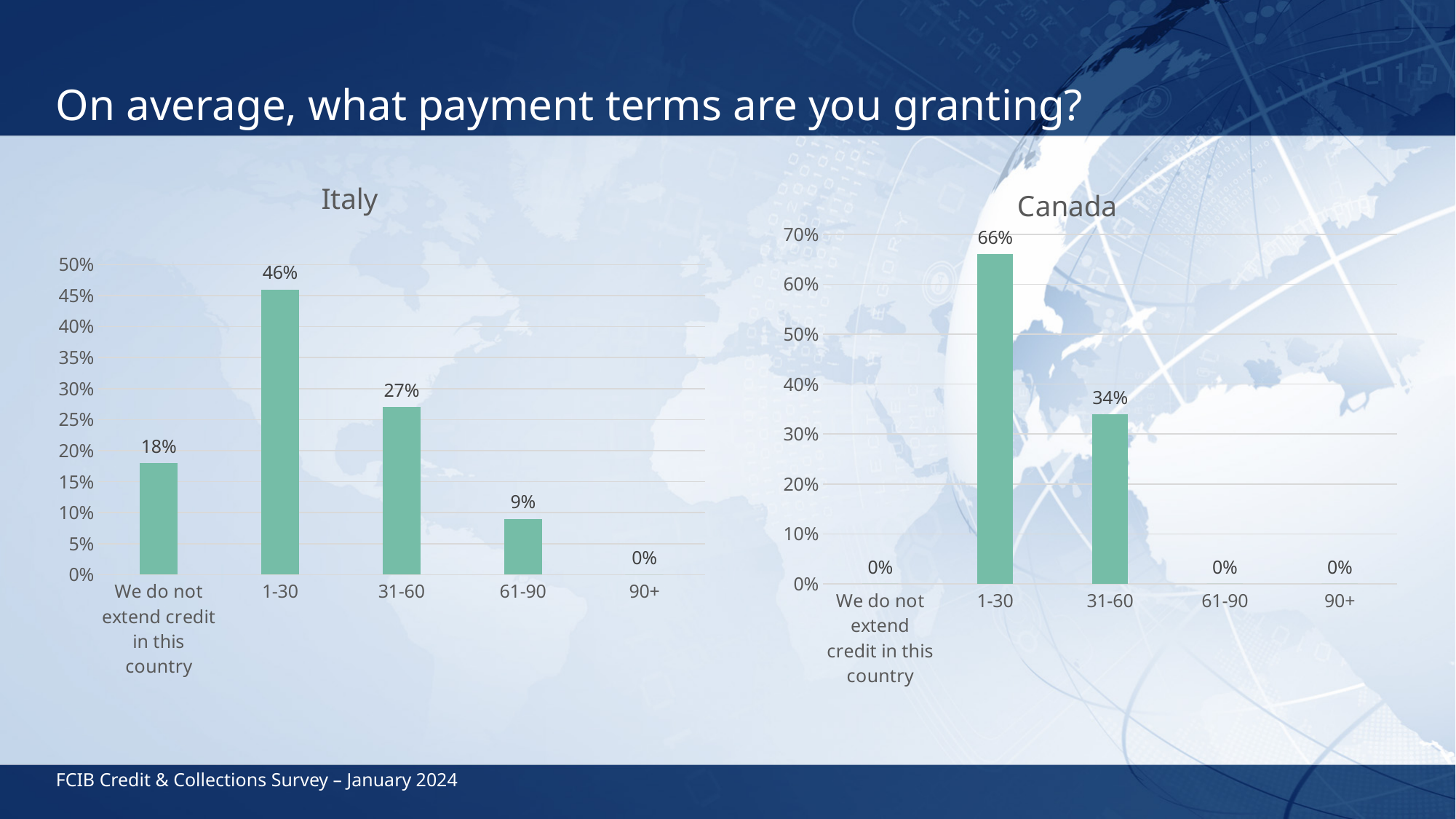
In the Canada chart, what is the value for 31-60? 34% In the Italy chart, what is the value for 1-30? 46% In the Italy chart, what is the difference between the values for 1-30 and 31-60? 19% In the Canada chart, what is the difference between the values for 1-30 and 31-60? 32% In the Canada chart, how many categories have a value of 0%? 3 How many categories are shown on the x axis of the Italy chart? 5 In the Italy chart, what is the value for 'We do not extend credit in this country'? 18% What kind of chart is the Canada chart? Bar chart In the Italy chart, which category has the highest value? 1-30 Which is larger: the value for 61-90 in the Italy chart or the value for 61-90 in the Canada chart? Italy What is the title of the chart on the left side of the slide? Italy In the Canada chart, which category has the highest value? 1-30